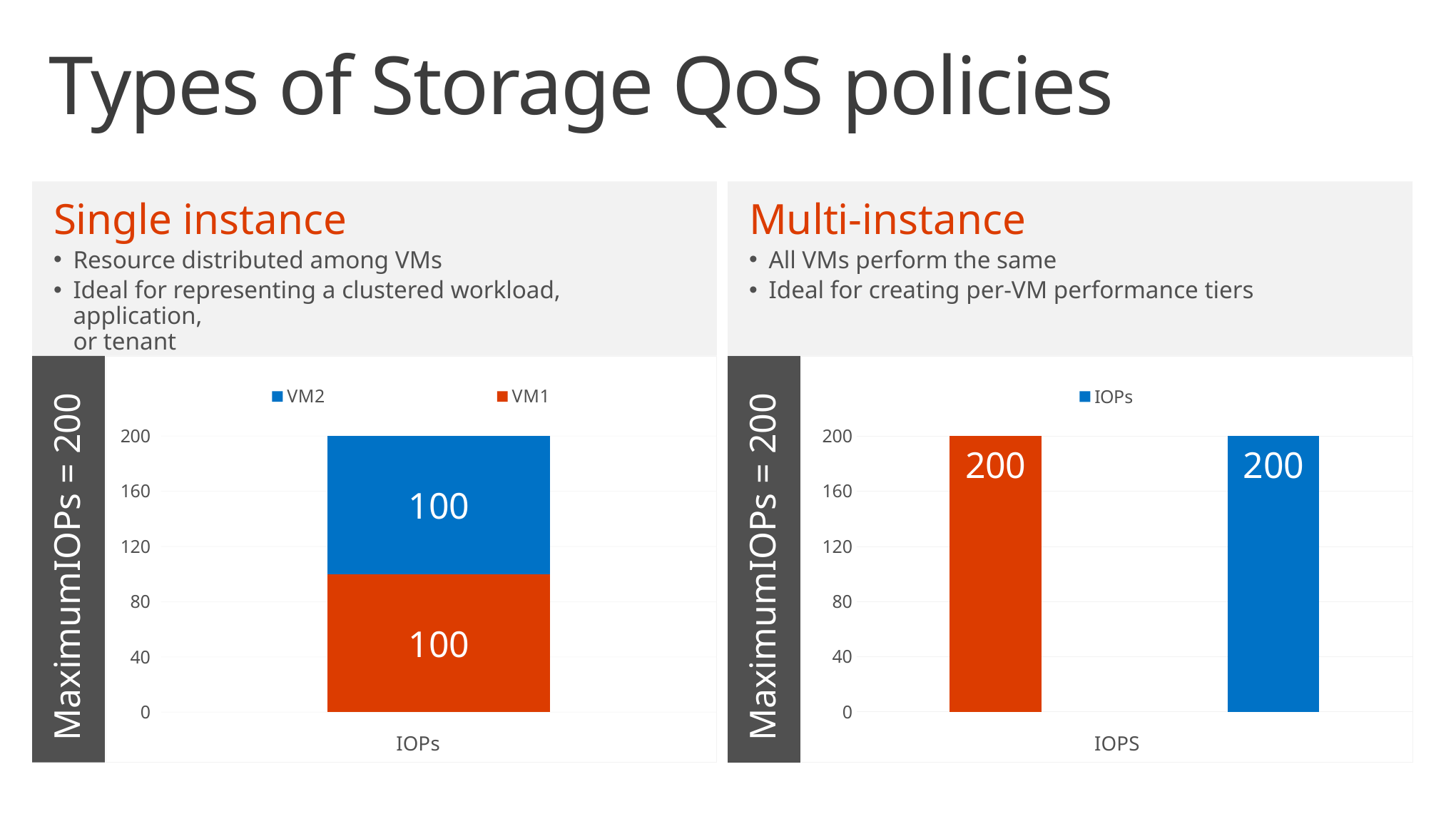
In the Multi-instance chart, how many bars are plotted? 2 In the Single instance chart, what is the value for VM2? 100 In the Single instance chart, what is the difference between the VM1 and VM2 values? 0 In the Multi-instance chart, what value is labelled on the blue bar? 200 In the Single instance chart, what is the value for VM1? 100 In the Multi-instance chart, what series name does the legend show? IOPs What kind of chart is the Single instance chart? Stacked bar chart In the Single instance chart, what is the total height of the stacked IOPs bar? 200 In the Single instance chart, what is the highest value shown on the vertical axis? 200 What kind of chart is the Multi-instance chart? Bar chart In the Single instance chart, how many series does the legend list? 2 In the Multi-instance chart, what value is labelled on the orange bar? 200